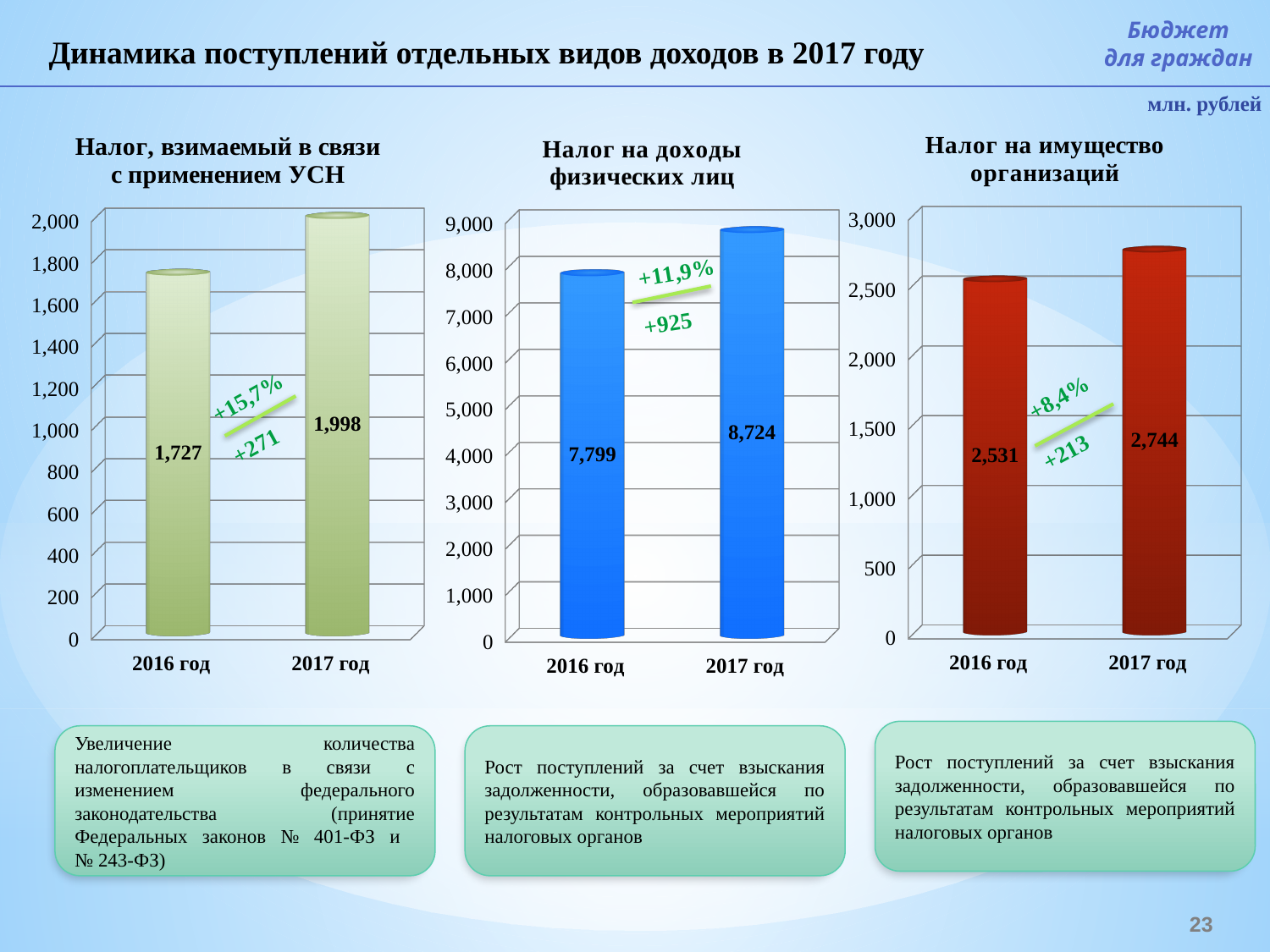
In the chart titled "Налог на имущество организаций", what is the value for 2017 год? 2,744 In the chart titled "Налог на доходы физических лиц", do the values rise or fall from 2016 год to 2017 год? rise In the chart titled "Налог, взимаемый в связи с применением УСН", which year has the higher value? 2017 год In the chart titled "Налог на имущество организаций", what is the difference between the 2017 год and 2016 год values? 213 In the chart titled "Налог, взимаемый в связи с применением УСН", what is the value for 2017 год? 1,998 In the chart titled "Налог на доходы физических лиц", what is the value for 2016 год? 7,799 In the chart titled "Налог на имущество организаций", which year has the lower value? 2016 год In the chart titled "Налог на доходы физических лиц", what is the difference between the 2017 год and 2016 год values? 925 What kind of chart is the chart titled "Налог на имущество организаций"? bar chart In the chart titled "Налог на доходы физических лиц", what is the value for 2017 год? 8,724 How many categories are shown on the x axis of the chart titled "Налог, взимаемый в связи с применением УСН"? 2 In the chart titled "Налог, взимаемый в связи с применением УСН", what is the value for 2016 год? 1,727